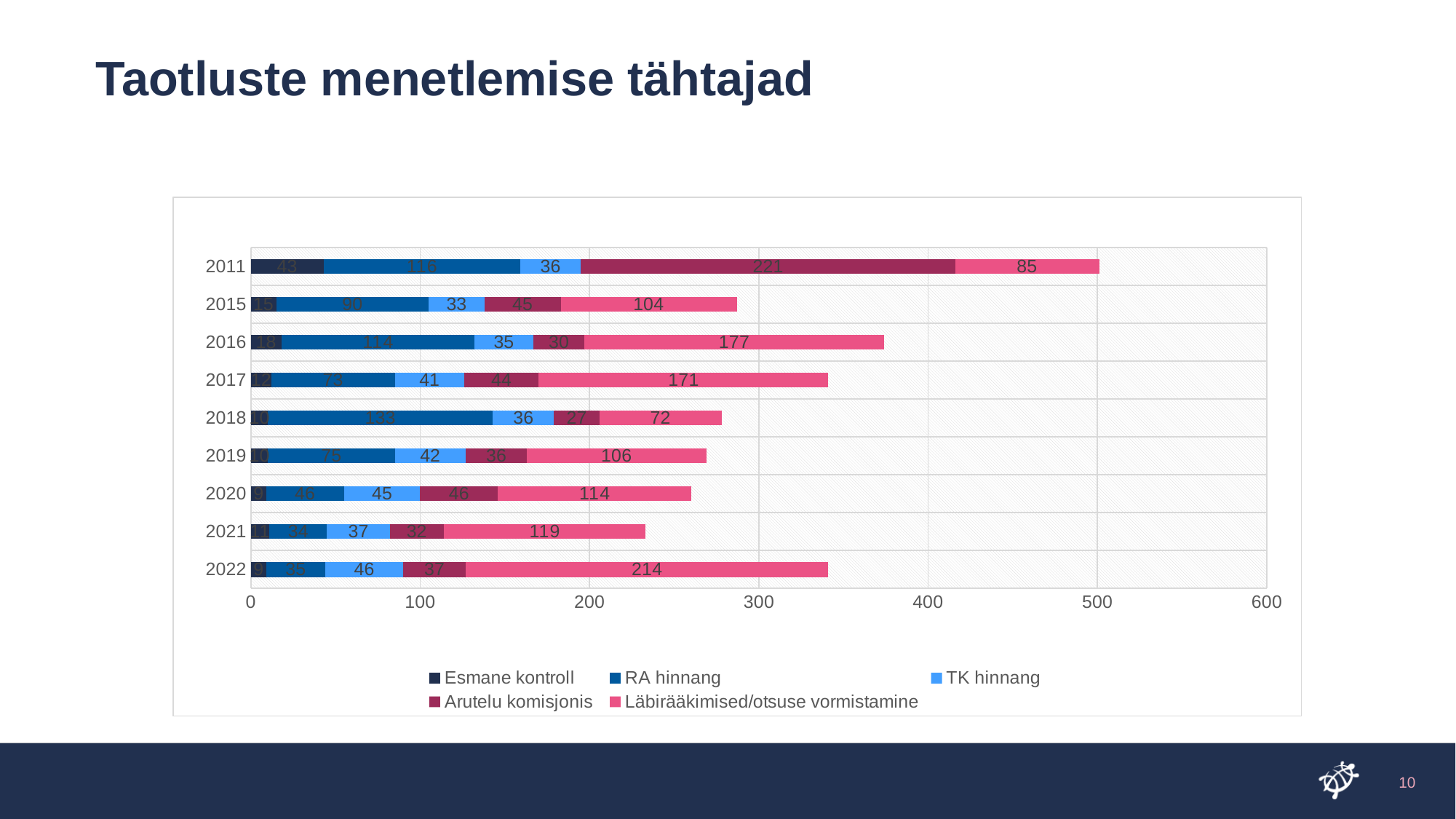
What is the difference between the Arutelu komisjonis values for 2011 and 2015? 176 Which year has the lowest value for Läbirääkimised/otsuse vormistamine? 2018 Which year has the highest value for Läbirääkimised/otsuse vormistamine? 2022 Is the total length of the stacked bar for 2016 greater or less than 300? greater What is the value of Arutelu komisjonis for 2011? 221 What is the value of RA hinnang for 2018? 133 How many years are shown on the vertical axis? 9 What is the value of Läbirääkimised/otsuse vormistamine for 2022? 214 Which year has the larger RA hinnang value, 2016 or 2017? 2016 How many series does the legend list? 5 What is the total of the stacked bar for 2011? 501 What kind of chart is shown on the slide? bar chart